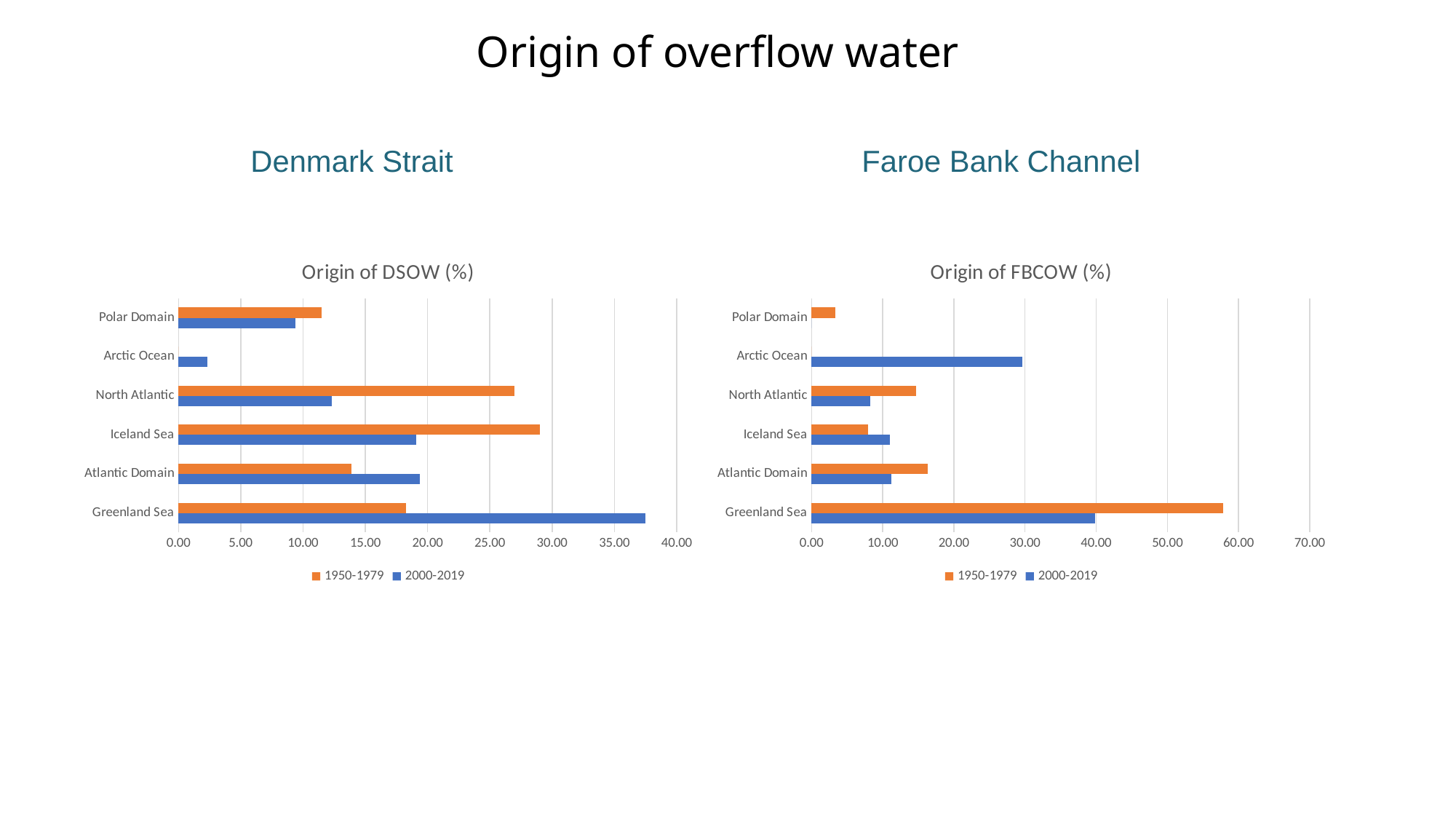
In the 'Origin of DSOW (%)' chart, is the 2000-2019 value for Greenland Sea greater or less than 35.00? greater In the 'Origin of DSOW (%)' chart, which category has the highest value for the 1950-1979 series? Iceland Sea In the 'Origin of FBCOW (%)' chart, which series has the larger value for North Atlantic, 1950-1979 or 2000-2019? 1950-1979 How many categories are shown on the 'Origin of DSOW (%)' chart? 6 In the 'Origin of FBCOW (%)' chart, is the 2000-2019 value for Arctic Ocean greater or less than 20.00? greater In the 'Origin of DSOW (%)' chart, what colour represents the 1950-1979 series? orange What kind of chart is the 'Origin of DSOW (%)' chart on the left? bar chart In the 'Origin of FBCOW (%)' chart, is the 1950-1979 value for Greenland Sea greater or less than 50.00? greater How many series does the legend of the 'Origin of FBCOW (%)' chart list? 2 In the 'Origin of DSOW (%)' chart, which category has the highest value for the 2000-2019 series? Greenland Sea In the 'Origin of FBCOW (%)' chart, which category has the highest value for the 1950-1979 series? Greenland Sea In the 'Origin of DSOW (%)' chart, which series has the larger value for Atlantic Domain, 1950-1979 or 2000-2019? 2000-2019